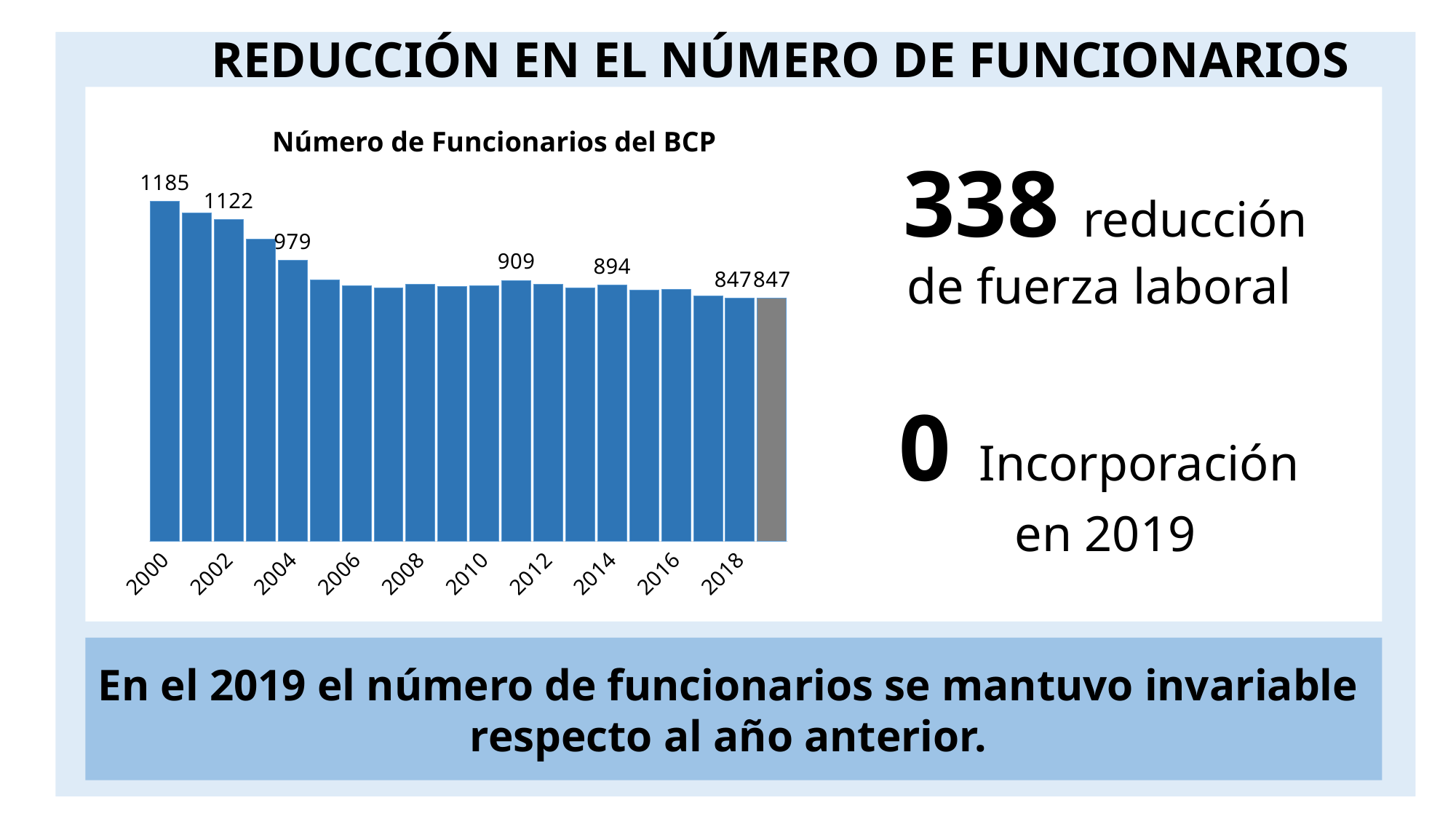
What type of chart is shown on the slide? bar chart Do the values generally rise or fall from 2000 to 2019? fall What is the number of funcionarios in 2004? 979 What is the difference between the number of funcionarios in 2000 and in 2019? 338 What is the number of funcionarios in 2014? 894 Which year has the highest number of funcionarios? 2000 What is the title of the chart on the slide? Número de Funcionarios del BCP What is the number of funcionarios in 2019? 847 What is the number of funcionarios in 2000? 1185 Which is larger, the number of funcionarios in 2004 or in 2014? 2004